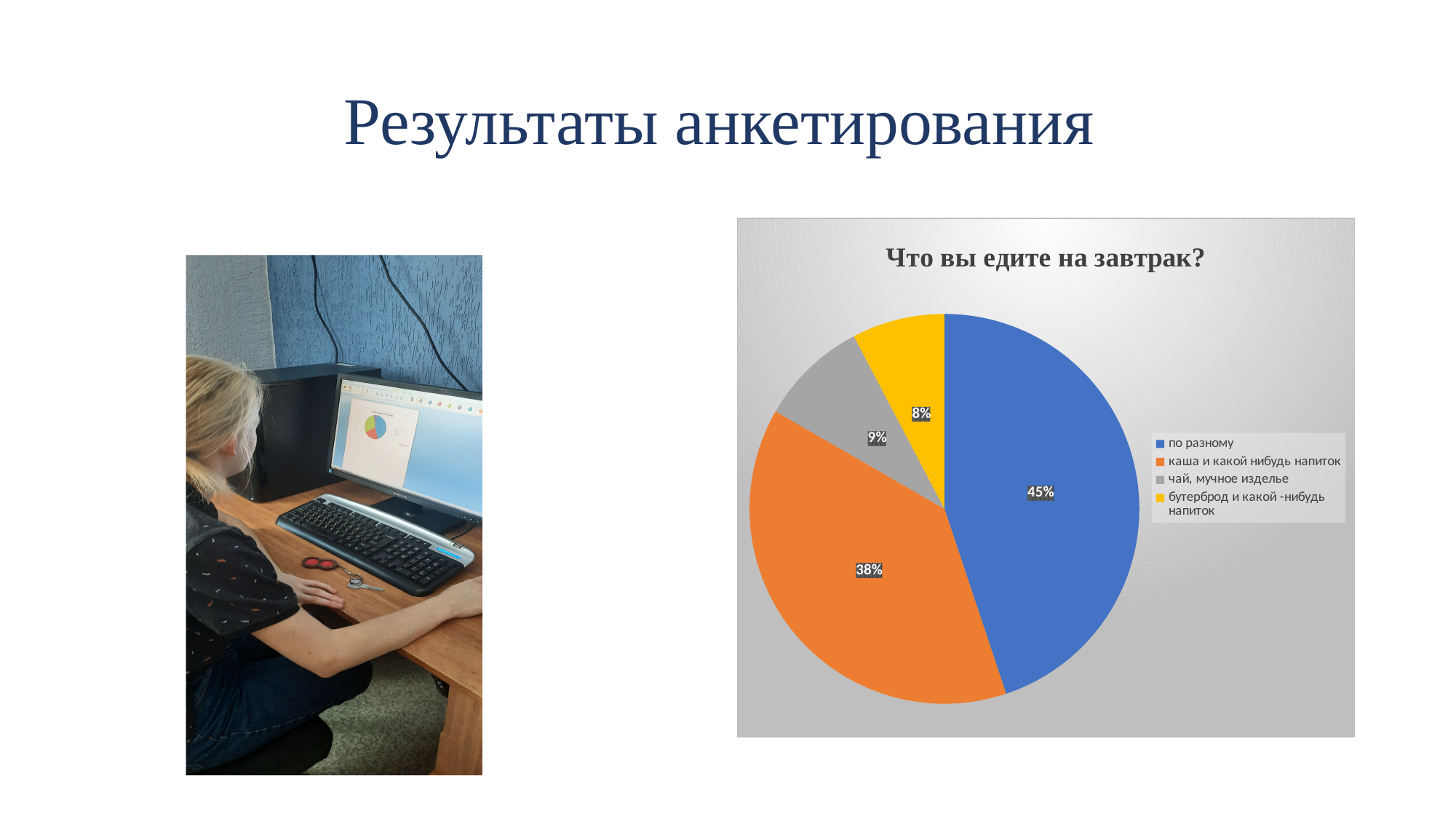
What percentage of the pie is labelled for "по разному"? 45% What percentage is shown for "каша и какой нибудь напиток"? 38% What is the title of the chart? Что вы едите на завтрак? Which is larger: the share for "по разному" or the share for "чай, мучное изделье"? по разному What colour is the slice for "каша и какой нибудь напиток"? orange What percentage is shown for "чай, мучное изделье"? 9% What is the difference in percentage points between "по разному" and "каша и какой нибудь напиток"? 7 What type of chart is shown on the slide? pie chart Which category has the smallest share of the pie? бутерброд и какой -нибудь напиток Which category has the largest share of the pie? по разному How many categories does the legend list? 4 What percentage is shown for "бутерброд и какой -нибудь напиток"? 8%